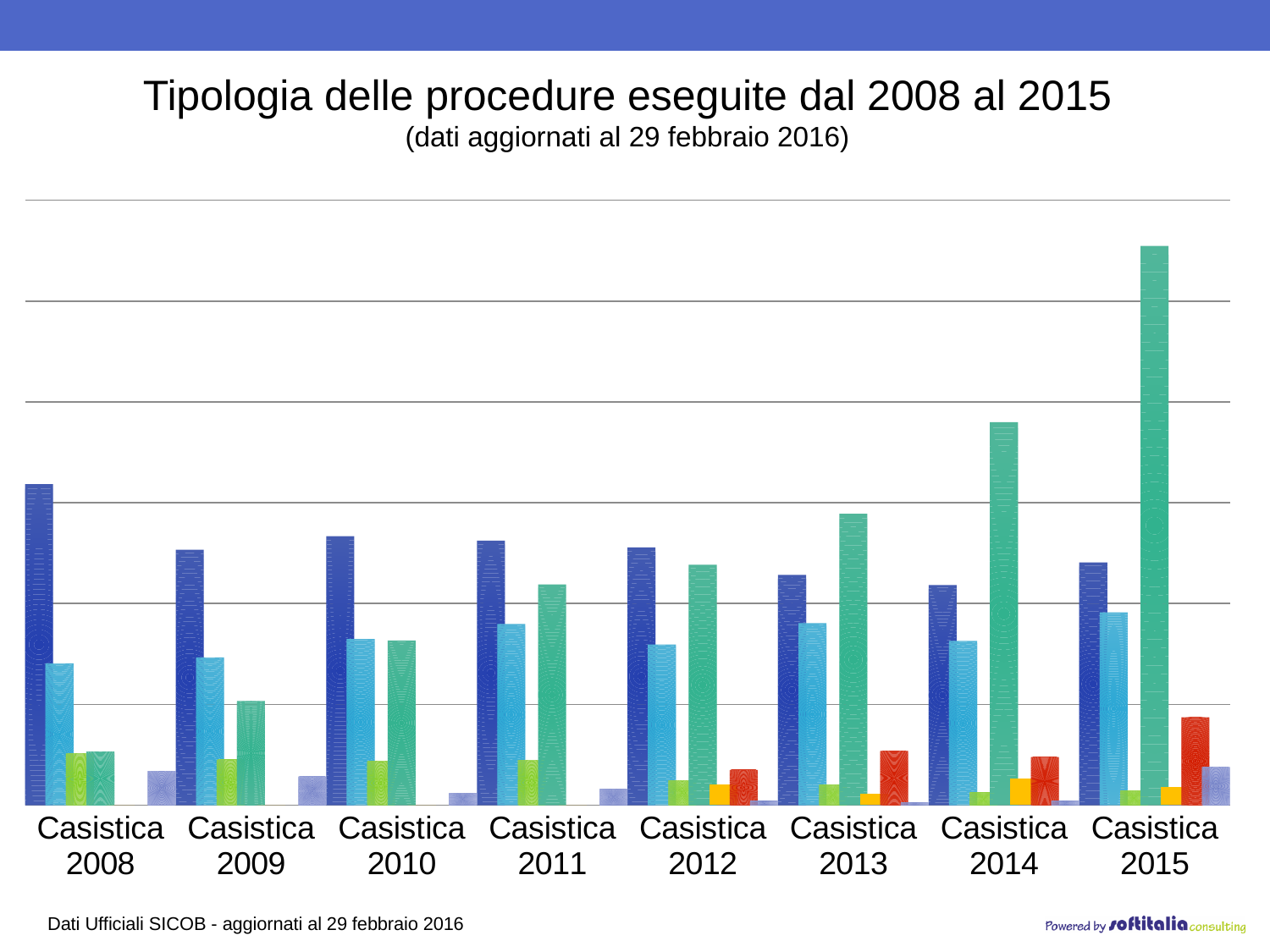
Which category has a taller tallest bar, Casistica 2015 or Casistica 2008? Casistica 2015 In which category does the tallest bar of the whole chart appear? Casistica 2015 How many categories are shown along the x axis of the chart? 8 Which category has a taller tallest bar, Casistica 2008 or Casistica 2009? Casistica 2008 What kind of chart is shown on the slide? bar chart What is the first category label on the x axis of the chart? Casistica 2008 What is the title of the chart on the slide? Tipologia delle procedure eseguite dal 2008 al 2015 Which category has a taller tallest bar, Casistica 2014 or Casistica 2013? Casistica 2014